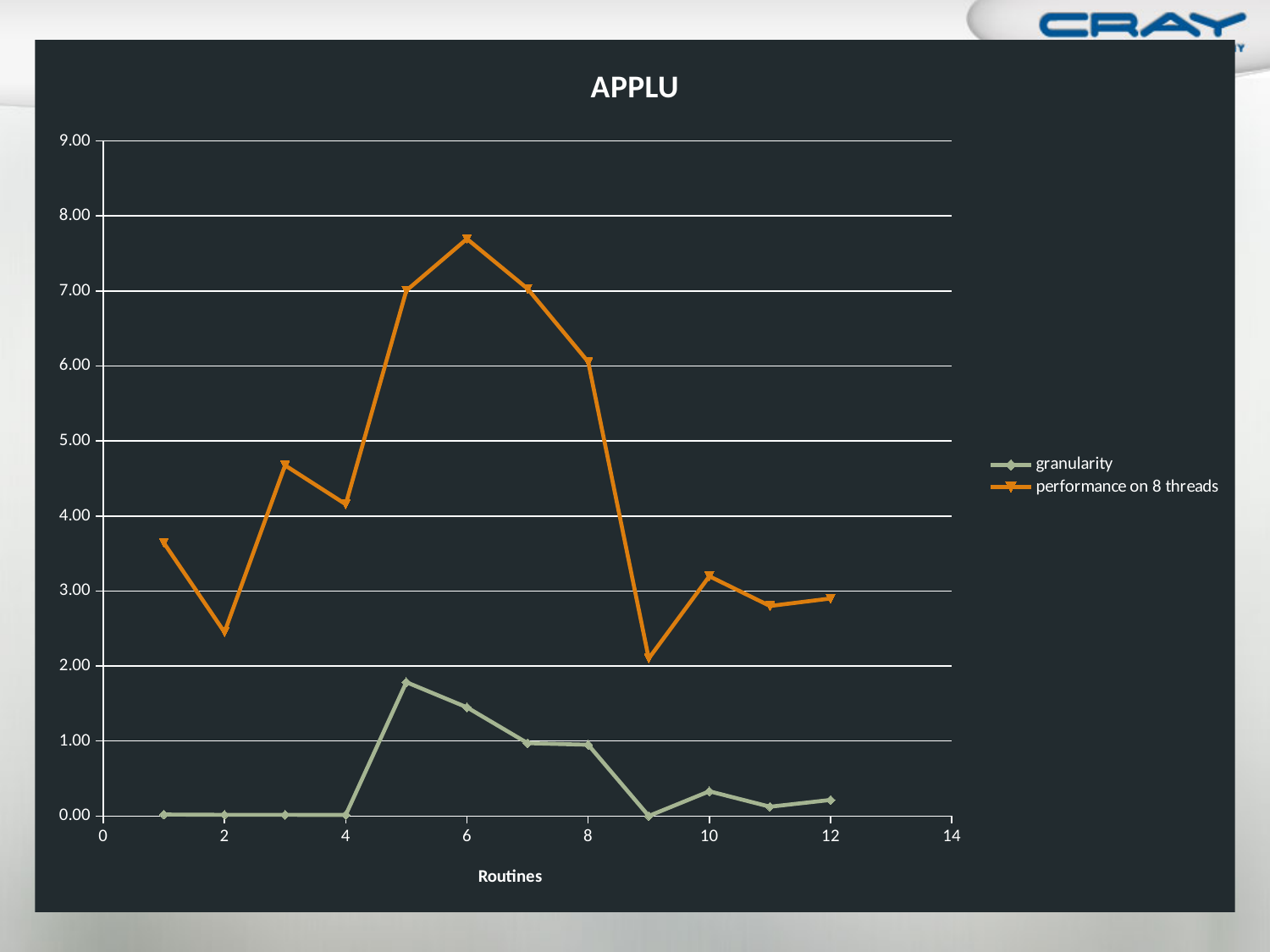
Is the value of 'performance on 8 threads' at routine 9 greater or less than 3.00? less At which routine does the 'performance on 8 threads' series reach its lowest value? 9 Is the value of 'granularity' at routine 5 greater or less than 1.00? greater At which routine does the 'granularity' series reach its highest value? 5 How many series does the legend list? 2 At which routine does the 'performance on 8 threads' series reach its highest value? 6 Which is larger for the 'granularity' series: the value at routine 5 or the value at routine 6? routine 5 What kind of chart is shown on the slide? line chart How many data points are plotted for the 'performance on 8 threads' series? 12 What is the title of the chart? APPLU Is the value of 'performance on 8 threads' at routine 6 greater or less than 7.00? greater What is the label of the x axis? Routines